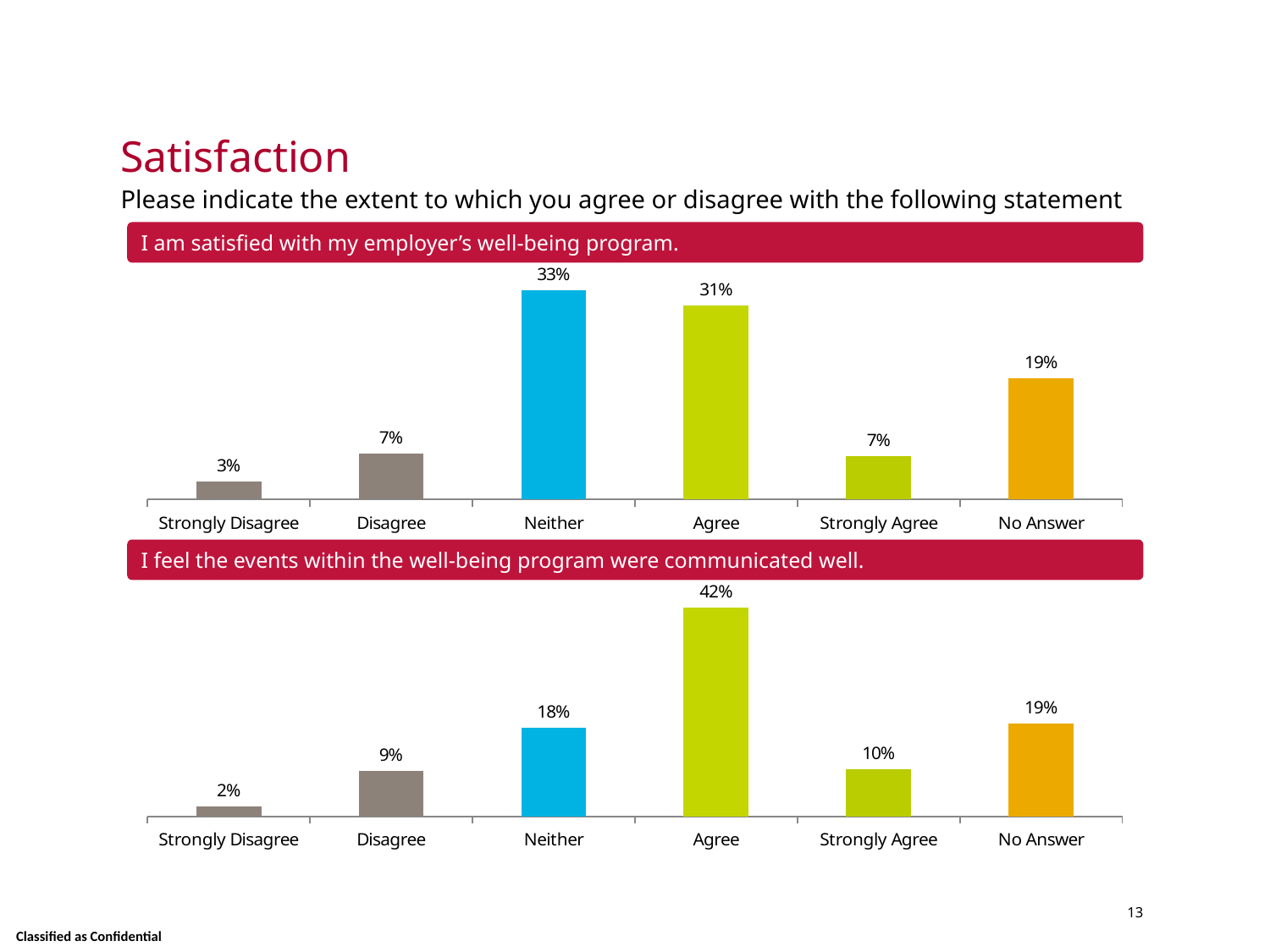
In the chart 'I feel the events within the well-being program were communicated well.', what is the value for No Answer? 19% In the chart 'I feel the events within the well-being program were communicated well.', what is the difference between the values for Agree and Neither? 24% How many categories are shown in the chart 'I am satisfied with my employer's well-being program.'? 6 In the chart 'I am satisfied with my employer's well-being program.', which category has the highest value? Neither In the chart 'I feel the events within the well-being program were communicated well.', what is the value for Agree? 42% In the chart 'I am satisfied with my employer's well-being program.', what is the difference between the values for Agree and No Answer? 12% In the chart 'I feel the events within the well-being program were communicated well.', which category has the lowest value? Strongly Disagree What kind of chart is used for 'I feel the events within the well-being program were communicated well.'? Bar chart In the chart 'I feel the events within the well-being program were communicated well.', which is larger, Disagree or Strongly Agree? Strongly Agree In the chart 'I am satisfied with my employer's well-being program.', what is the value for Neither? 33% In the chart 'I am satisfied with my employer's well-being program.', which is larger, Strongly Disagree or Disagree? Disagree In the chart 'I am satisfied with my employer's well-being program.', what is the value for Strongly Agree? 7%